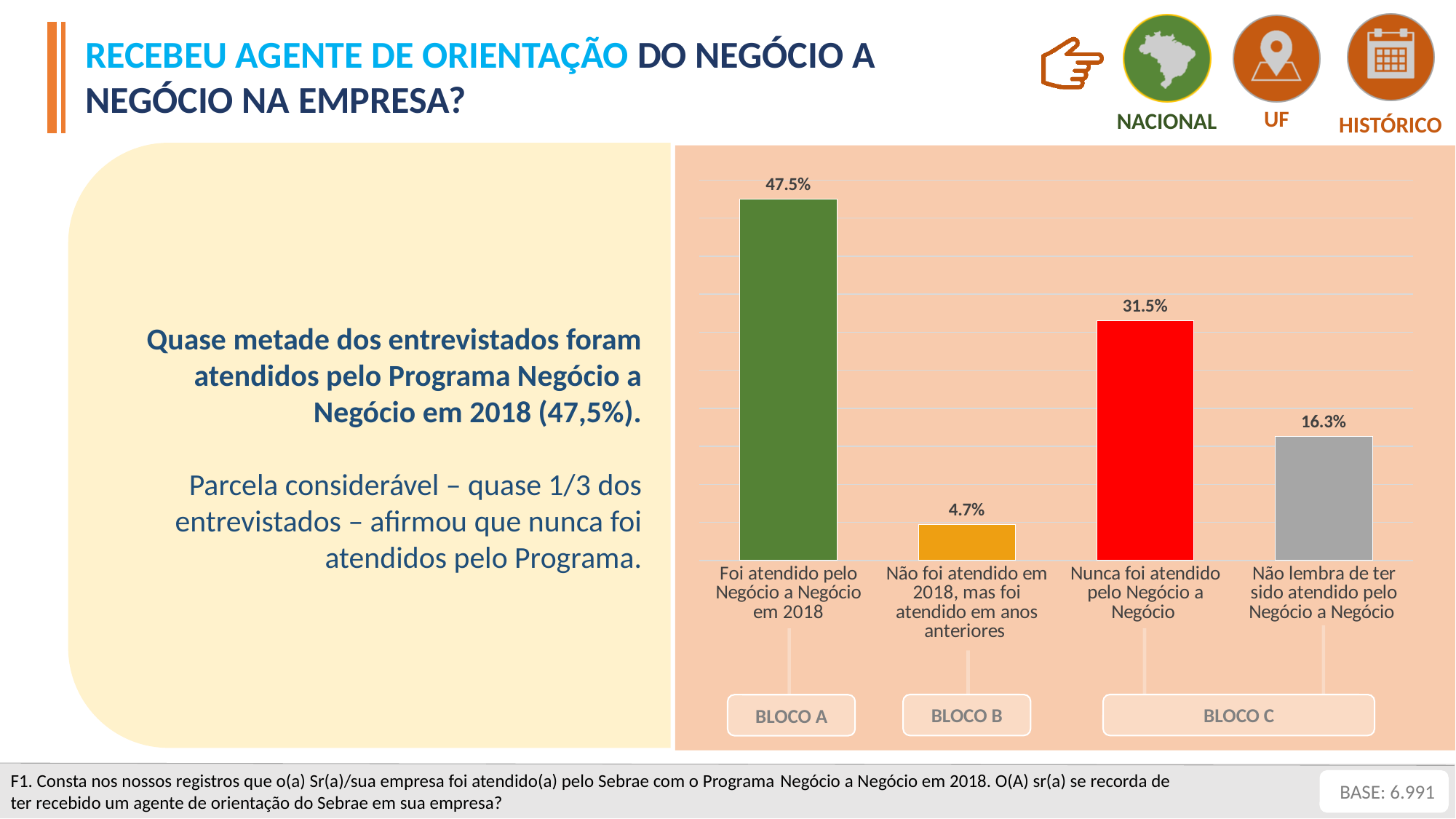
What is the value for "Nunca foi atendido pelo Negócio a Negócio"? 31.5% What is the difference between the values for "Nunca foi atendido pelo Negócio a Negócio" and "Não lembra de ter sido atendido pelo Negócio a Negócio"? 15.2% What is the value for "Foi atendido pelo Negócio a Negócio em 2018"? 47.5% How many categories are shown in the chart? 4 What kind of chart is shown on the slide? Bar chart Which is larger: the value for "Não lembra de ter sido atendido pelo Negócio a Negócio" or the value for "Não foi atendido em 2018, mas foi atendido em anos anteriores"? Não lembra de ter sido atendido pelo Negócio a Negócio Which bloco label is shown beneath the bar for "Não foi atendido em 2018, mas foi atendido em anos anteriores"? BLOCO B Which category has the lowest value? Não foi atendido em 2018, mas foi atendido em anos anteriores Which category has the highest value? Foi atendido pelo Negócio a Negócio em 2018 What is the difference between the values for "Foi atendido pelo Negócio a Negócio em 2018" and "Nunca foi atendido pelo Negócio a Negócio"? 16.0% What is the value for "Não lembra de ter sido atendido pelo Negócio a Negócio"? 16.3% What is the value for "Não foi atendido em 2018, mas foi atendido em anos anteriores"? 4.7%